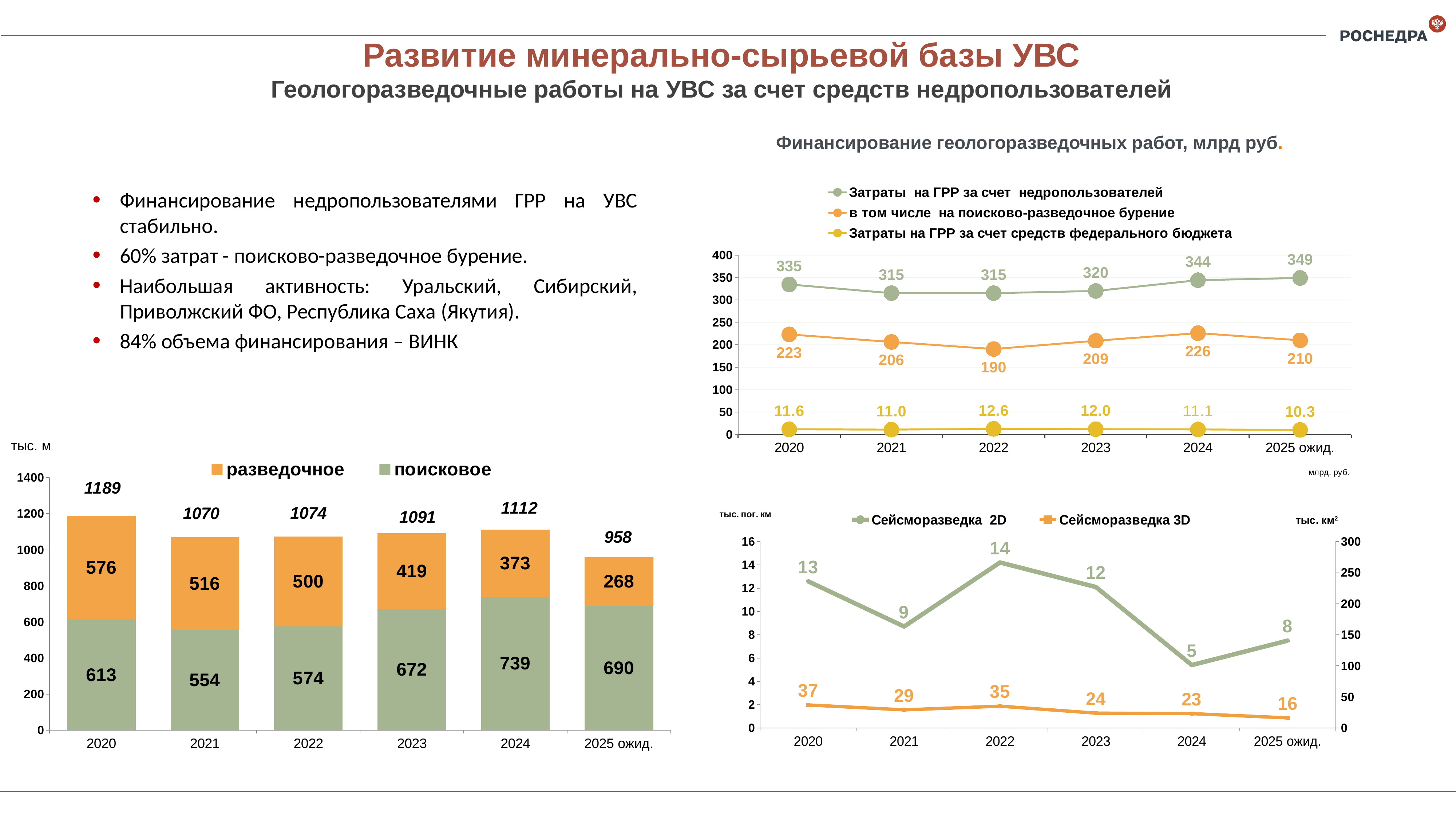
In the chart 'Финансирование геологоразведочных работ, млрд руб.', what is the value of 'Затраты на ГРР за счет средств федерального бюджета' for 2025 ожид.? 10.3 In the stacked bar chart at the bottom left, what is the 'поисковое' value for 2024? 739 In the stacked bar chart at the bottom left, what is the total of the bar for 2020? 1189 In the chart 'Финансирование геологоразведочных работ, млрд руб.', how many series does the legend list? 3 In the chart 'Финансирование геологоразведочных работ, млрд руб.', what is the difference between 'Затраты на ГРР за счет недропользователей' in 2025 ожид. and in 2024? 5 In the stacked bar chart at the bottom left, which year has the lowest total? 2025 ожид. In the bottom-right chart, in which year is 'Сейсморазведка 2D' highest? 2022 In the stacked bar chart at the bottom left, does the 'разведочное' value rise or fall from 2020 to 2025 ожид.? Falls In the chart 'Финансирование геологоразведочных работ, млрд руб.', in which year is 'в том числе на поисково-разведочное бурение' lowest? 2022 What kind of chart is the one at the bottom left of the slide? Stacked bar chart In the chart 'Финансирование геологоразведочных работ, млрд руб.', what is the value of 'Затраты на ГРР за счет недропользователей' for 2020? 335 In the bottom-right chart, what is the 'Сейсморазведка 3D' value for 2020? 37